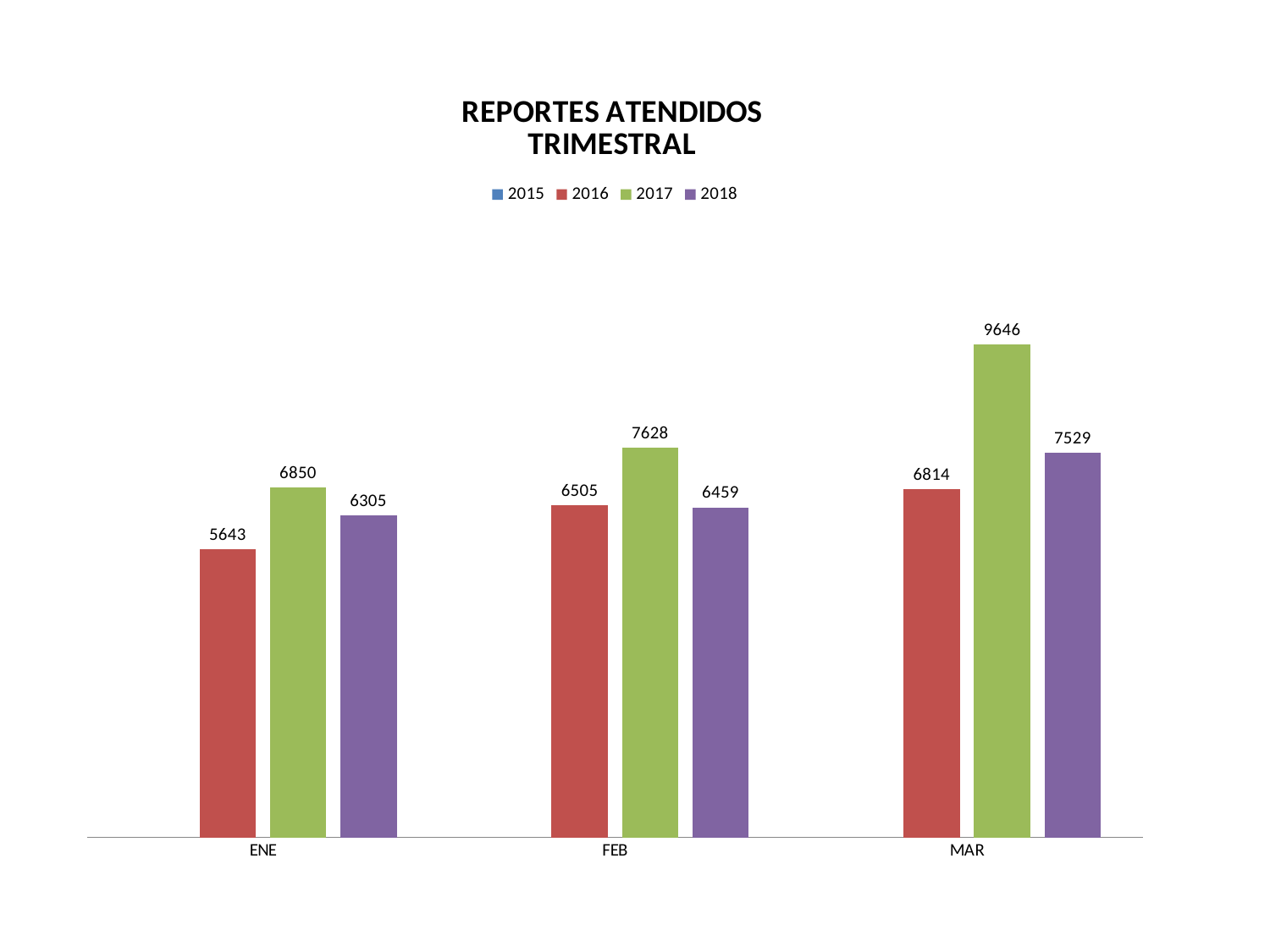
Which month has the lowest value for 2016? ENE Do the values for 2016 rise or fall from ENE to MAR? rise What is the value for 2017 in MAR? 9646 Which month has the highest value for 2017? MAR How many months are shown on the x axis? 3 What is the title of the chart? REPORTES ATENDIDOS TRIMESTRAL What is the difference between the 2017 and 2016 values in MAR? 2832 Which is larger in FEB, the value for 2016 or the value for 2018? 2016 What is the value for 2018 in FEB? 6459 What is the value for 2016 in ENE? 5643 What kind of chart is shown on the slide? bar chart How many series does the legend list? 4